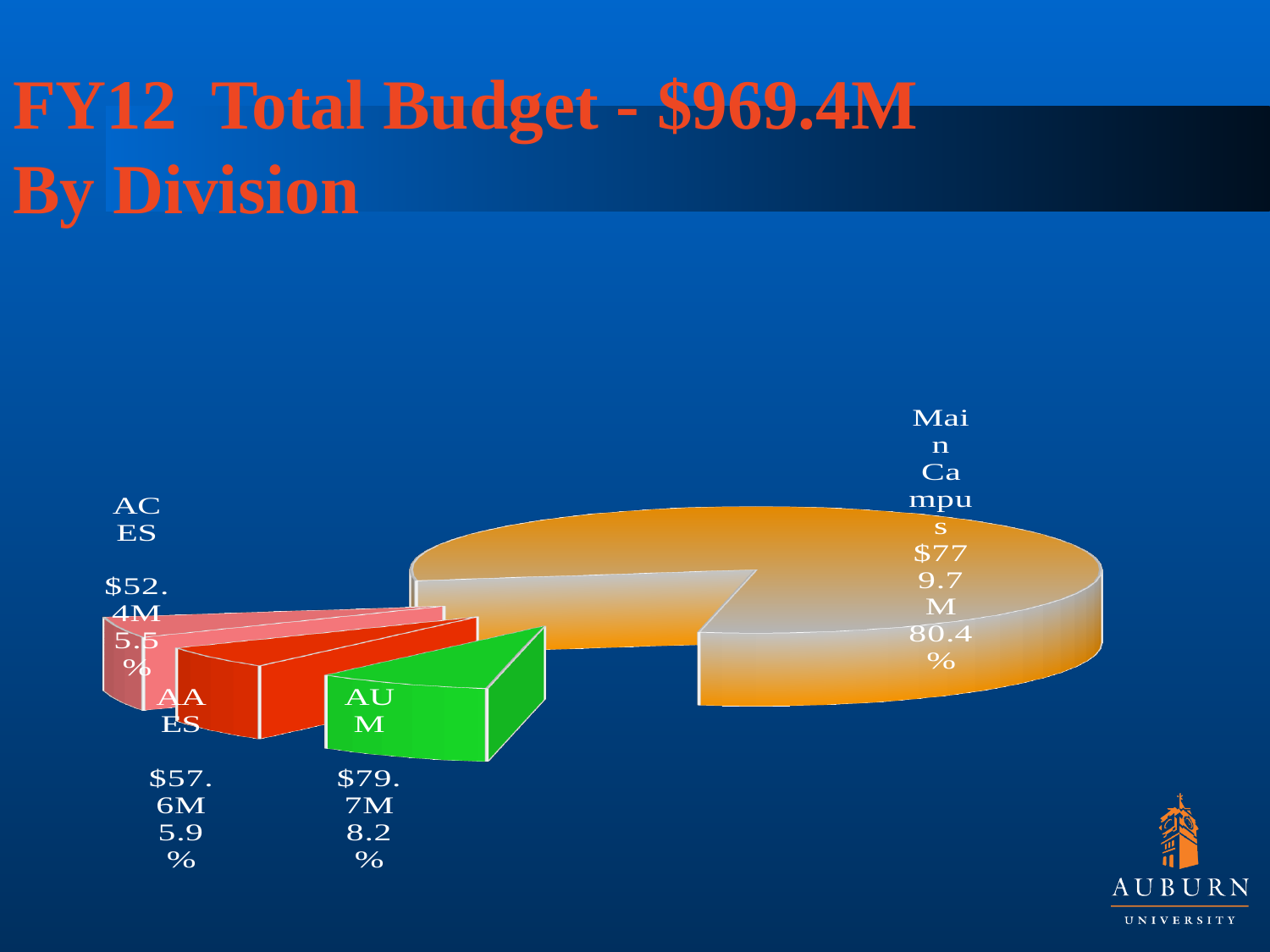
What is the budget value shown for Main Campus? $779.7M How many slices does the pie chart have? 4 What share of the pie does AAES represent? 5.9% Which division has the smallest slice of the pie? ACES What is the difference between the AAES budget and the ACES budget? $5.2M What share of the pie does Main Campus represent? 80.4% Which division has the largest slice of the pie? Main Campus What kind of chart is shown on the slide? pie chart Which is larger, the budget for AUM or the budget for AAES? AUM What is the budget value shown for AUM? $79.7M What is the budget value shown for AAES? $57.6M What is the budget value shown for ACES? $52.4M